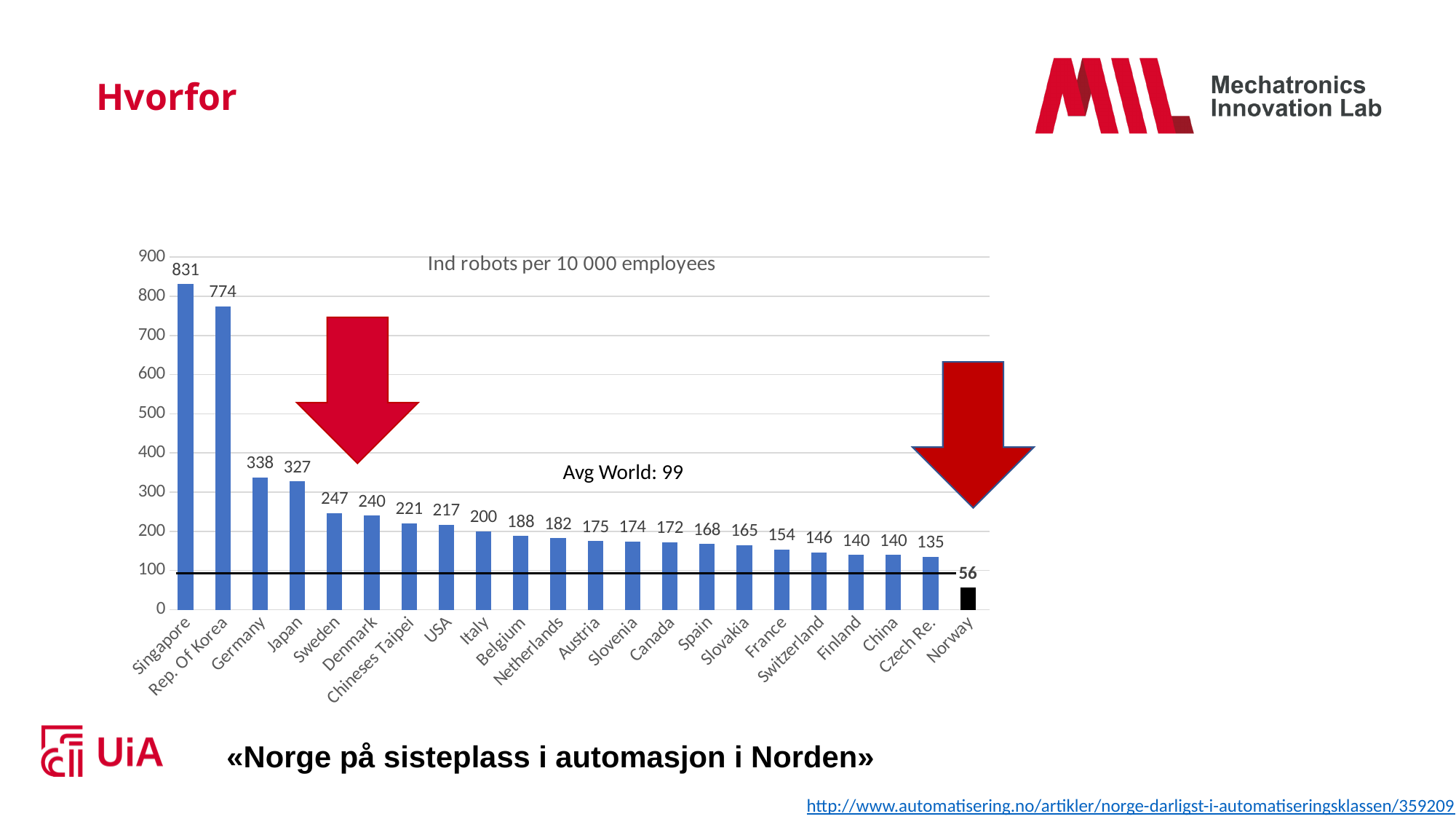
Which has a larger value, Germany or Japan? Germany What is the value for Sweden? 247 Which country has the highest value? Singapore What type of chart is shown on the slide? bar chart Do the values rise or fall from left to right along the x axis? fall Which country has the lowest value? Norway What is the title of the chart? Ind robots per 10 000 employees What is the value for Singapore? 831 What is the difference between the values for Singapore and Rep. Of Korea? 57 What is the value for Norway? 56 What world average value is annotated on the chart? Avg World: 99 How many countries are shown in the chart? 22